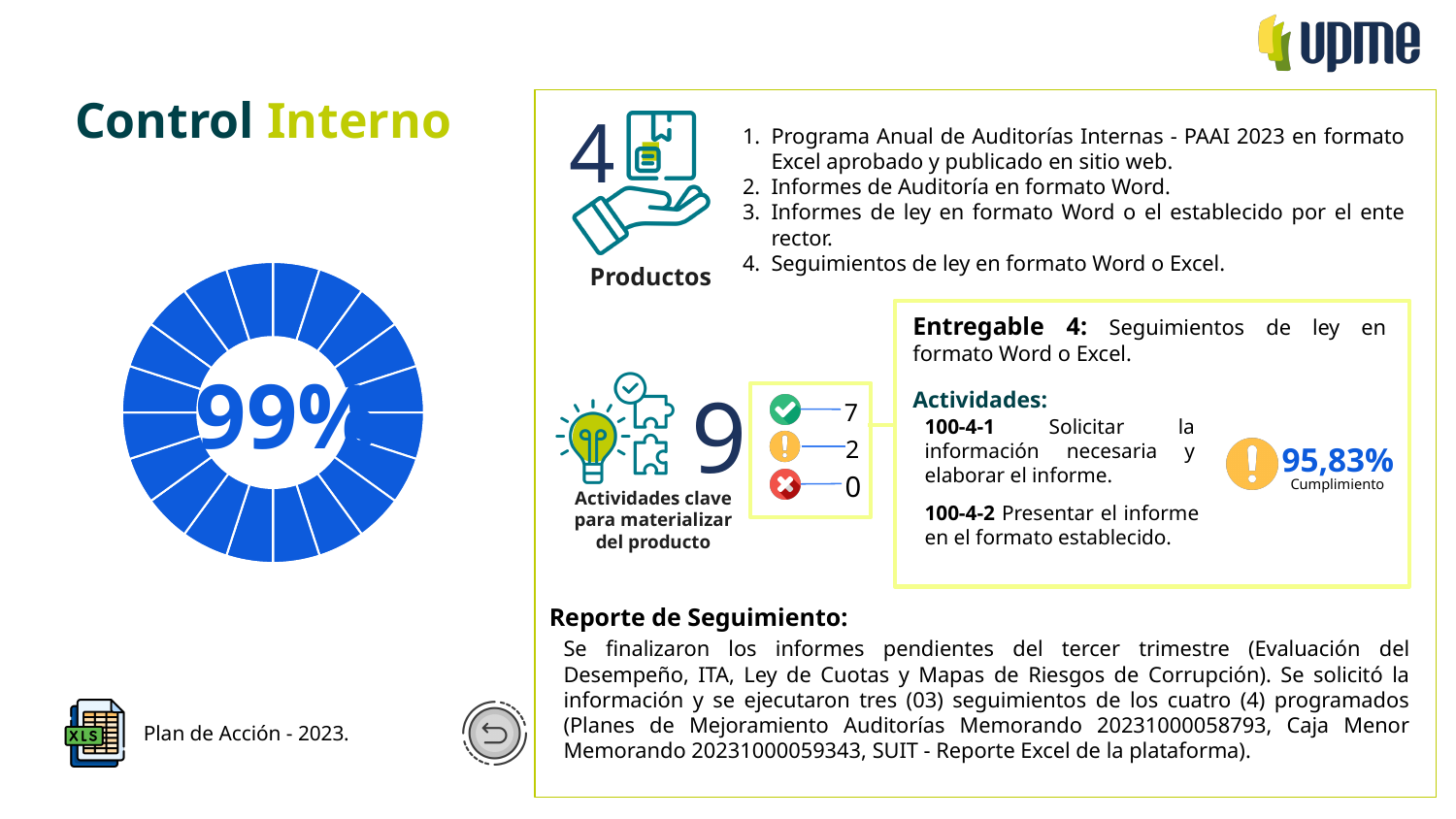
In the status indicator next to "Actividades clave para materializar del producto", what number is shown beside the green check icon? 7 What kind of chart is shown on the left side of the slide under the heading "Control Interno"? Donut chart Is the value shown in the donut chart greater or less than 50%? greater What percentage of "Cumplimiento" is shown next to the Entregable 4 activities? 95,83% In the status indicator next to "Actividades clave para materializar del producto", which status icon has the highest count? Green check What heading appears above the donut chart on the left of the slide? Control Interno In the status indicator next to "Actividades clave para materializar del producto", how many status categories are shown? 3 What percentage is shown in the centre of the donut chart on the left of the slide? 99% In the status indicator next to "Actividades clave para materializar del producto", what is the difference between the green check count and the orange warning count? 5 In the status indicator next to "Actividades clave para materializar del producto", what number is shown beside the red X icon? 0 In the status indicator next to "Actividades clave para materializar del producto", what number is shown beside the orange warning icon? 2 What colour are the segments of the donut chart on the left of the slide? Blue